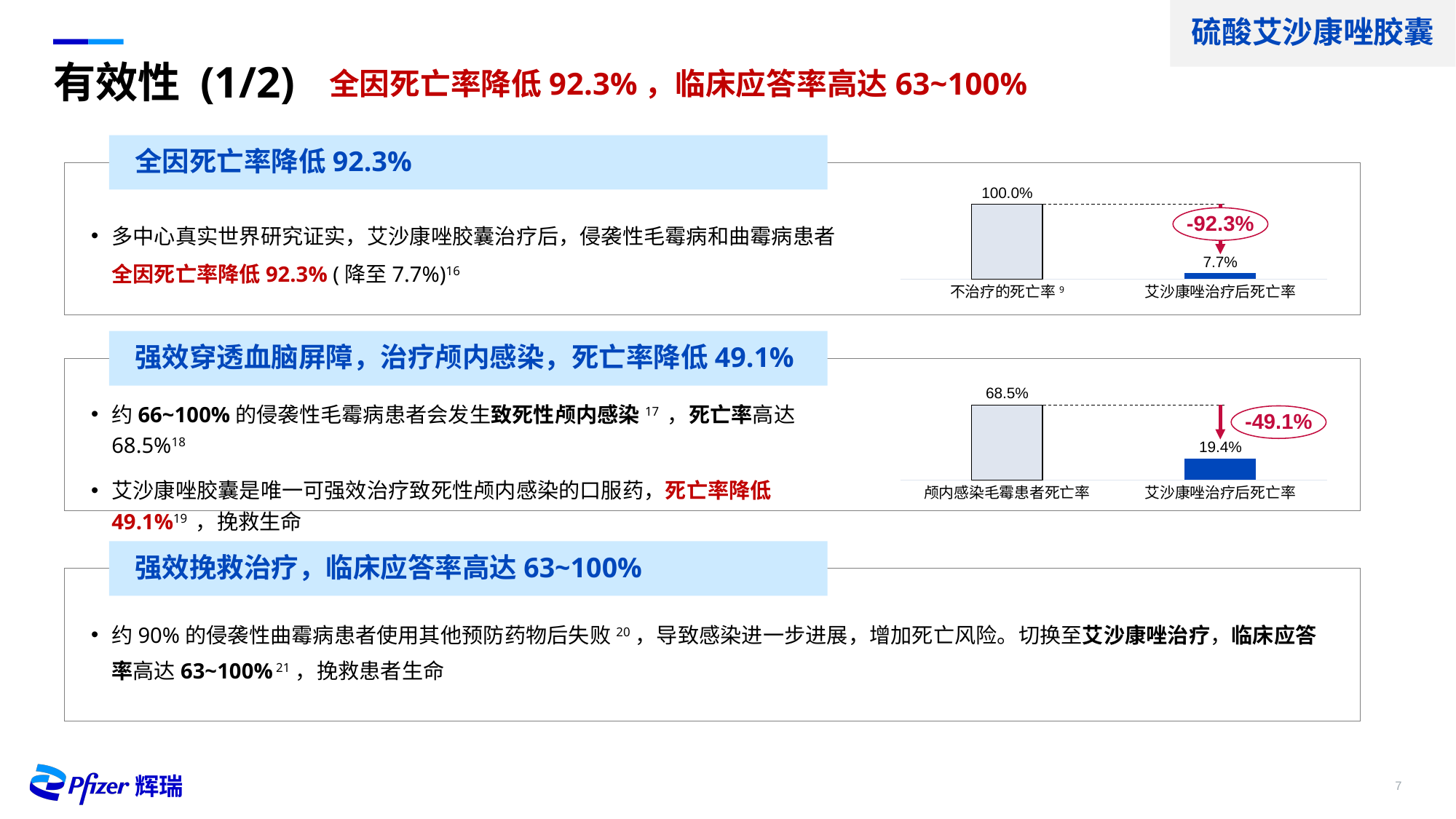
In the middle chart (死亡率降低 49.1%), what percentage change is shown in the red oval? -49.1% In the middle chart (死亡率降低 49.1%), what is the value for 艾沙康唑治疗后死亡率? 19.4% In the top chart (全因死亡率降低 92.3%), which category has the lower value? 艾沙康唑治疗后死亡率 In the middle chart (死亡率降低 49.1%), what is the value for 颅内感染毛霉患者死亡率? 68.5% In the top chart (全因死亡率降低 92.3%), what percentage change is shown in the red oval? -92.3% In the top chart (全因死亡率降低 92.3%), what is the difference between 不治疗的死亡率 and 艾沙康唑治疗后死亡率? 92.3% In the top chart (全因死亡率降低 92.3%), what is the value for 不治疗的死亡率? 100.0% In the middle chart (死亡率降低 49.1%), which category has the higher value? 颅内感染毛霉患者死亡率 In the top chart (全因死亡率降低 92.3%), how many bars are plotted? 2 In the middle chart (死亡率降低 49.1%), what is the difference between 颅内感染毛霉患者死亡率 and 艾沙康唑治疗后死亡率? 49.1% What kind of chart is the top chart (全因死亡率降低 92.3%)? Bar chart In the top chart (全因死亡率降低 92.3%), what is the value for 艾沙康唑治疗后死亡率? 7.7%